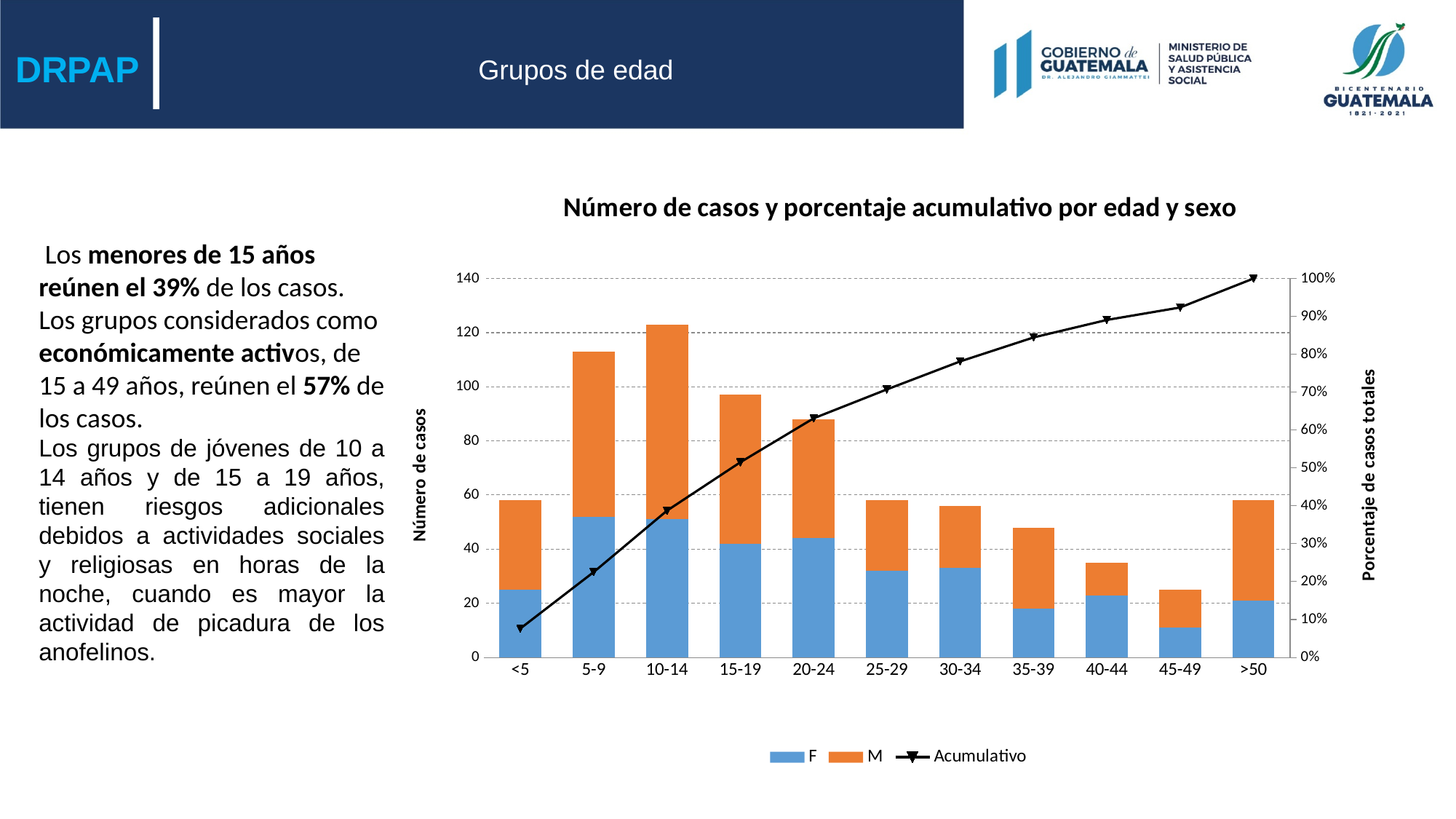
What kind of chart is shown on the slide? A stacked bar chart combined with a line Is the cumulative percentage (Acumulativo) for the <5 age group greater or less than 10%? less Is the cumulative percentage (Acumulativo) for the 35-39 age group greater or less than 80%? greater Is the total number of cases for the 5-9 age group greater or less than 100? greater How many age groups are shown on the x axis of the chart? 11 Does the Acumulativo line rise or fall across the age groups from <5 to >50? It rises Which age group has the lowest total number of cases? 45-49 How many series does the chart legend list? 3 What is the title of the chart? Número de casos y porcentaje acumulativo por edad y sexo Which age group has the highest total number of cases? 10-14 Which age group has more total cases, 5-9 or 15-19? 5-9